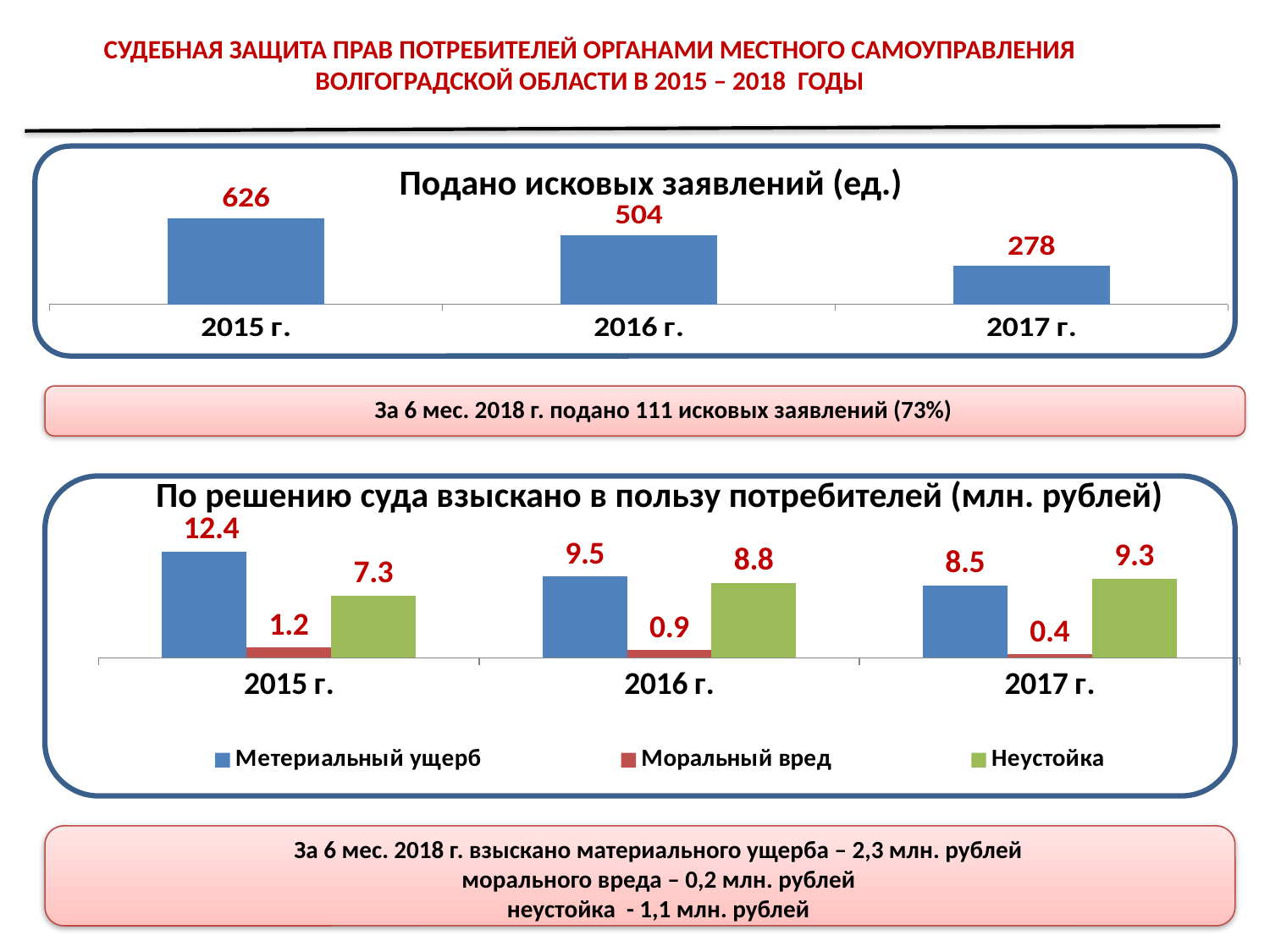
In the chart 'Подано исковых заявлений (ед.)', which year has the lowest value? 2017 г. In the chart 'Подано исковых заявлений (ед.)', what is the value for 2015 г.? 626 In the chart 'По решению суда взыскано в пользу потребителей (млн. рублей)', what is the difference between Неустойка for 2016 г. and 2015 г.? 1.5 What type of chart is 'По решению суда взыскано в пользу потребителей (млн. рублей)'? bar chart In the chart 'По решению суда взыскано в пользу потребителей (млн. рублей)', what is the value of Моральный вред for 2016 г.? 0.9 In the chart 'По решению суда взыскано в пользу потребителей (млн. рублей)', which year has the highest value of Метериальный ущерб? 2015 г. In the chart 'По решению суда взыскано в пользу потребителей (млн. рублей)', how many series does the legend list? 3 In the chart 'По решению суда взыскано в пользу потребителей (млн. рублей)', which is larger for 2017 г.: Метериальный ущерб or Неустойка? Неустойка In the chart 'По решению суда взыскано в пользу потребителей (млн. рублей)', what is the value of Неустойка for 2017 г.? 9.3 In the chart 'Подано исковых заявлений (ед.)', how many years are shown? 3 In the chart 'Подано исковых заявлений (ед.)', do the values rise or fall from 2015 г. to 2017 г.? fall In the chart 'Подано исковых заявлений (ед.)', what is the difference between the values for 2015 г. and 2017 г.? 348